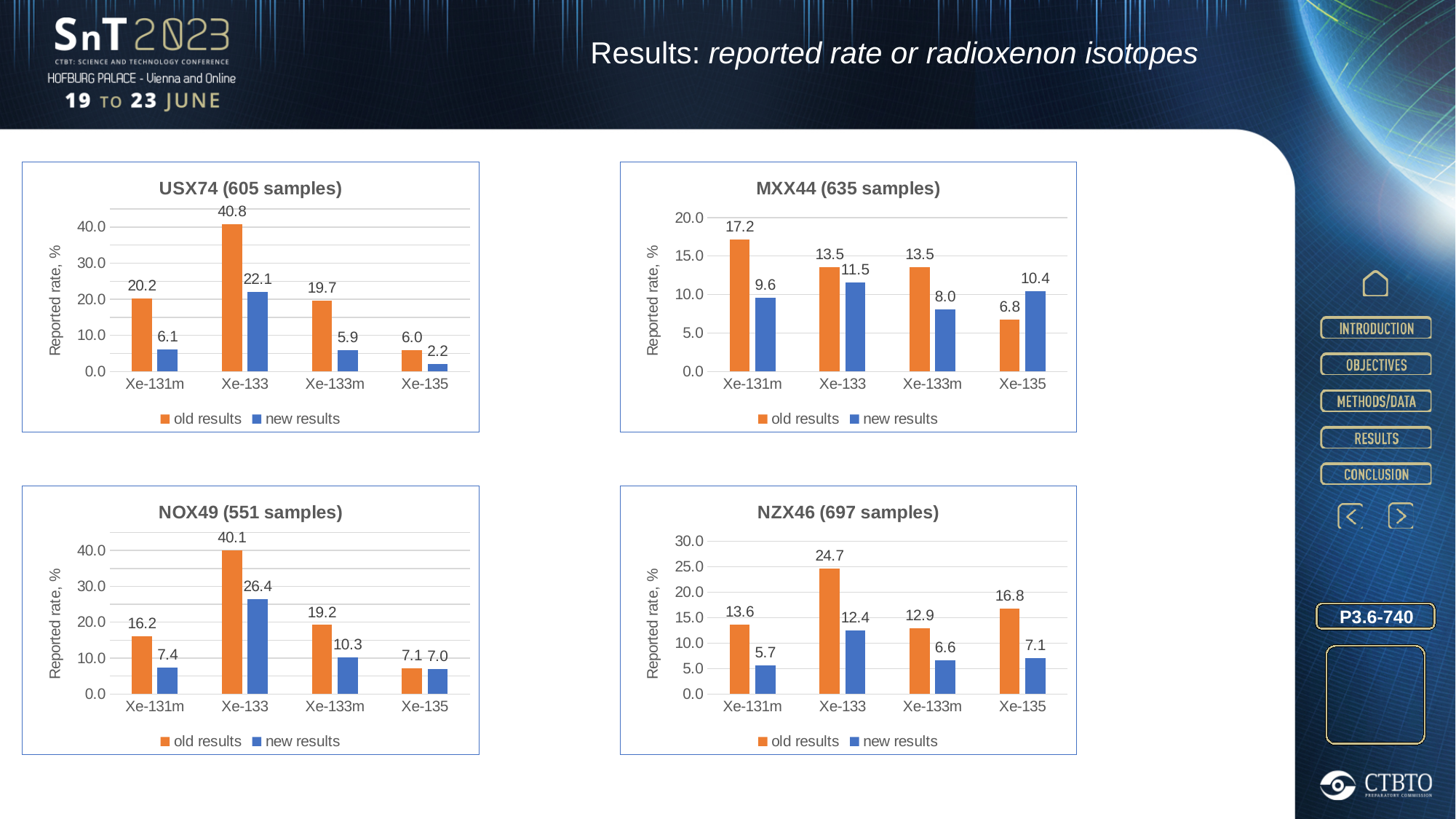
What kind of chart is the NZX46 (697 samples) chart? bar chart In the USX74 (605 samples) chart, what is the difference between the old and new results for Xe-131m? 14.1 In the MXX44 (635 samples) chart, which is larger for Xe-135: old results or new results? new results In the NOX49 (551 samples) chart, which isotope has the highest old results value? Xe-133 In the NZX46 (697 samples) chart, is the old results value for Xe-133 greater or less than 20.0? greater What is the y-axis label of the USX74 (605 samples) chart? Reported rate, % How many series does the legend of the MXX44 (635 samples) chart list? 2 In the MXX44 (635 samples) chart, what is the new results value for Xe-135? 10.4 How many isotope categories are shown on the x axis of the NOX49 (551 samples) chart? 4 In the USX74 (605 samples) chart, what is the old results value for Xe-133? 40.8 In the NOX49 (551 samples) chart, what is the new results value for Xe-133m? 10.3 In the NZX46 (697 samples) chart, which isotope has the lowest new results value? Xe-131m